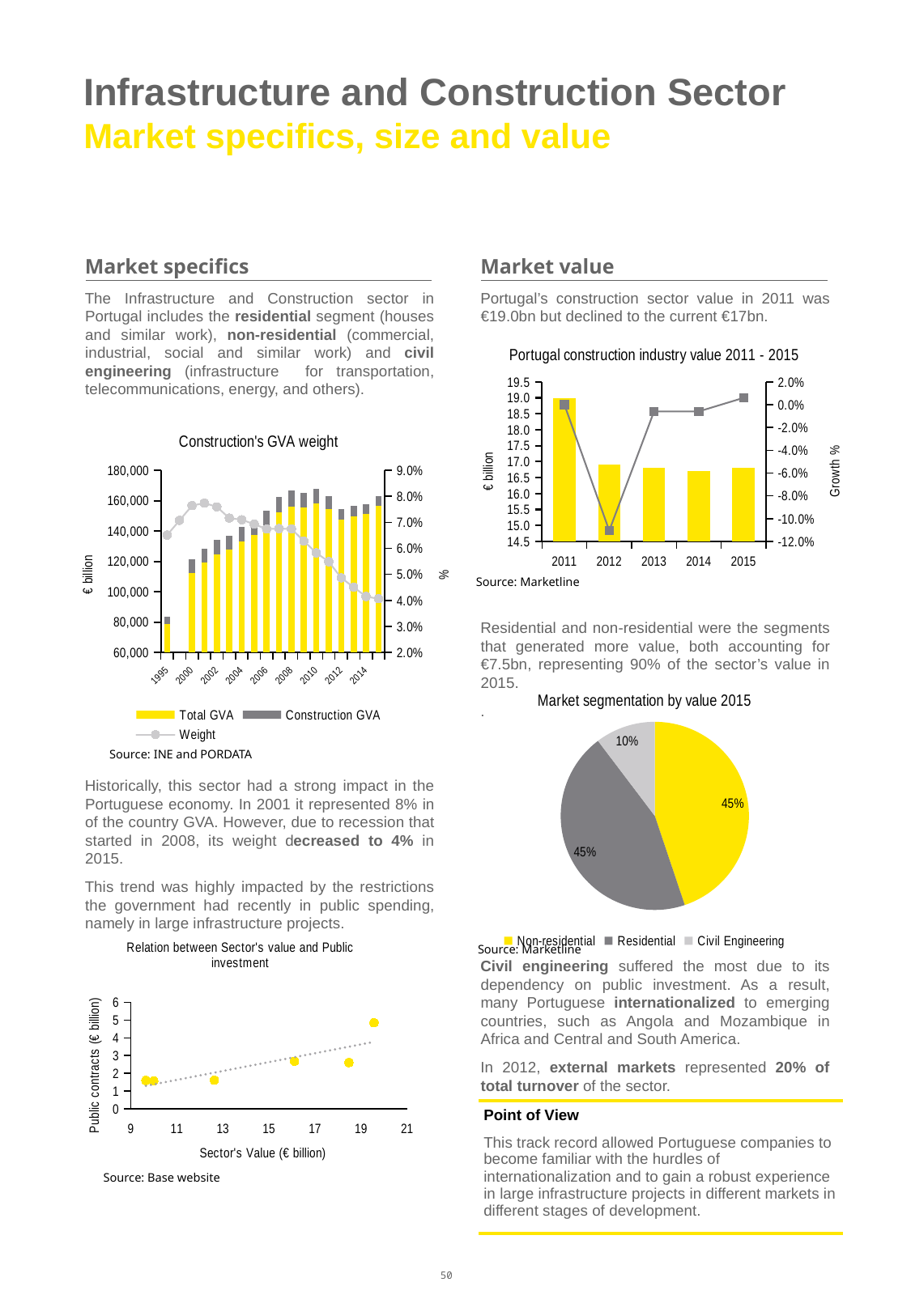
In the 'Portugal construction industry value 2011 - 2015' chart, is the growth % for 2012 greater or less than -8.0%? less How many series does the legend of the 'Construction's GVA weight' chart list? 3 In the 'Market segmentation by value 2015' pie chart, which segment has the smallest share? Civil Engineering In the 'Construction's GVA weight' chart, does the Weight line rise or fall from 2008 to 2015? fall In the 'Market segmentation by value 2015' pie chart, what share does Non-residential have? 45% In the 'Portugal construction industry value 2011 - 2015' chart, which year has the lowest growth %? 2012 How many segments does the 'Market segmentation by value 2015' pie chart show? 3 How many years are shown on the x axis of the 'Portugal construction industry value 2011 - 2015' chart? 5 In the 'Market segmentation by value 2015' pie chart, what share does Civil Engineering have? 10% In the 'Portugal construction industry value 2011 - 2015' chart, which year has the highest bar (€ billion)? 2011 What kind of chart is 'Relation between Sector's value and Public investment'? scatter chart In the 'Portugal construction industry value 2011 - 2015' chart, is the € billion value for 2011 greater or less than 18.0? greater